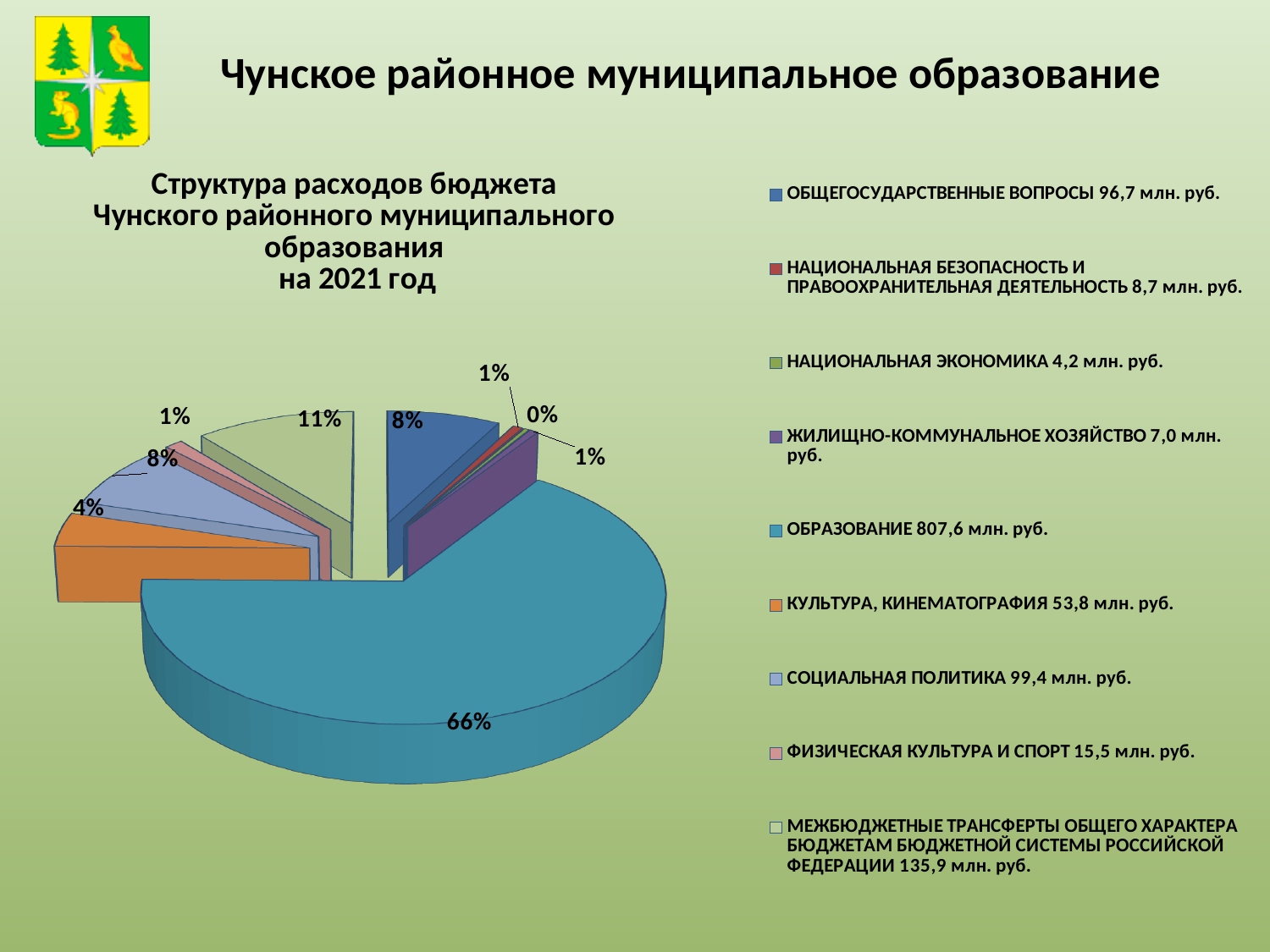
According to the legend, what is the amount for ОБРАЗОВАНИЕ? 807,6 млн. руб. What share of the pie is labelled for КУЛЬТУРА, КИНЕМАТОГРАФИЯ? 4% Which is larger according to the legend: ОБЩЕГОСУДАРСТВЕННЫЕ ВОПРОСЫ or ФИЗИЧЕСКАЯ КУЛЬТУРА И СПОРТ? ОБЩЕГОСУДАРСТВЕННЫЕ ВОПРОСЫ What is the title of the pie chart? Структура расходов бюджета Чунского районного муниципального образования на 2021 год What kind of chart is shown on the slide? pie chart Which category has the largest slice of the pie? ОБРАЗОВАНИЕ What is the difference between the legend amounts for СОЦИАЛЬНАЯ ПОЛИТИКА and ОБЩЕГОСУДАРСТВЕННЫЕ ВОПРОСЫ? 2,7 млн. руб. What share of the pie does ОБРАЗОВАНИЕ take? 66% Which category has the smallest slice of the pie? НАЦИОНАЛЬНАЯ ЭКОНОМИКА What share of the pie is labelled for МЕЖБЮДЖЕТНЫЕ ТРАНСФЕРТЫ ОБЩЕГО ХАРАКТЕРА БЮДЖЕТАМ БЮДЖЕТНОЙ СИСТЕМЫ РОССИЙСКОЙ ФЕДЕРАЦИИ? 11% How many categories does the legend of the pie chart list? 9 According to the legend, what is the amount for СОЦИАЛЬНАЯ ПОЛИТИКА? 99,4 млн. руб.